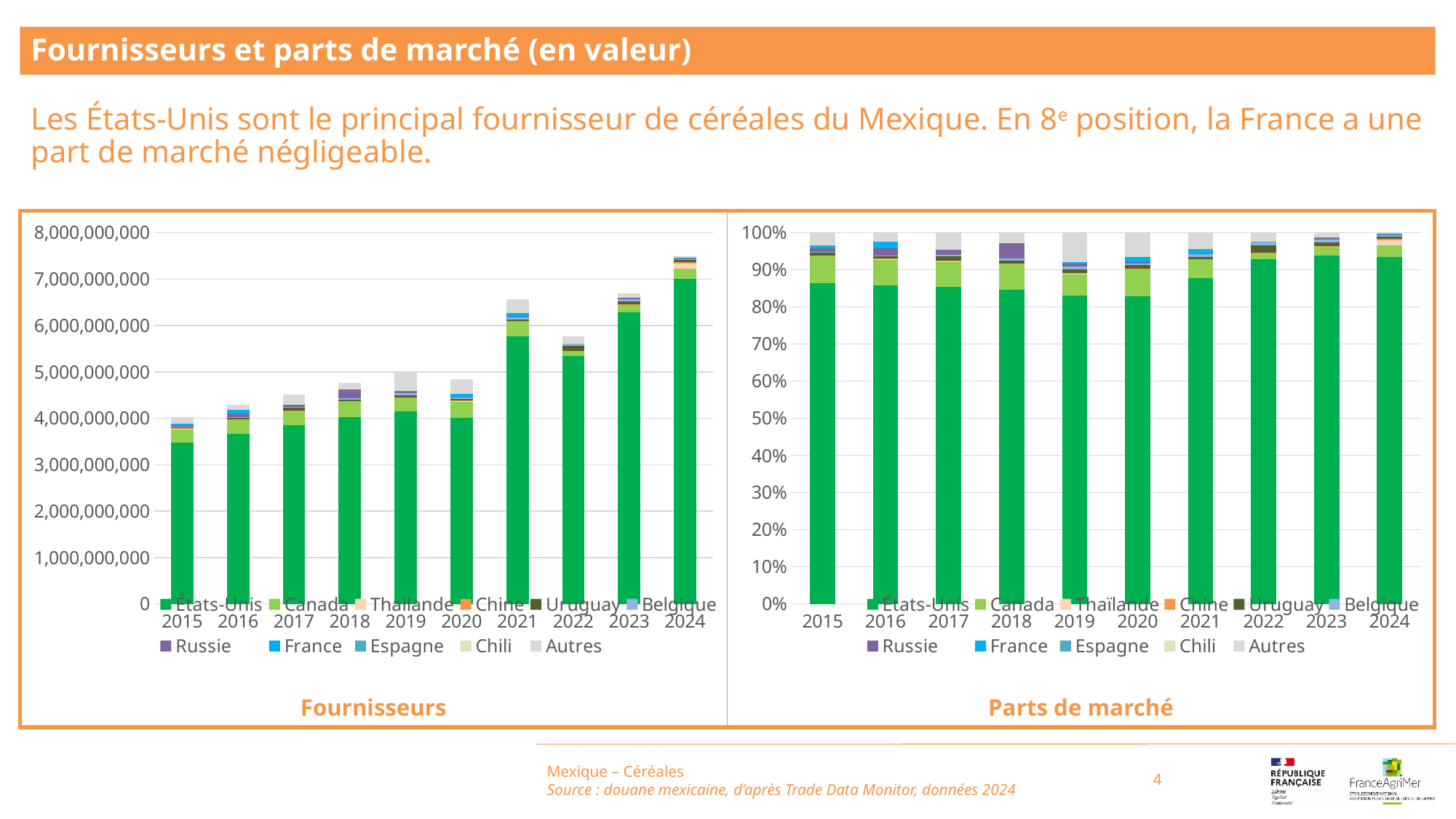
In the Fournisseurs chart, is the total bar for 2024 greater or less than 7,000,000,000? greater In the Fournisseurs chart, which year has the highest total bar? 2024 How many years are shown on the x axis of the Fournisseurs chart? 10 What kind of chart is the Fournisseurs chart on the left? stacked bar chart How many series does the legend of the Parts de marché chart list? 11 Which series is shown in dark green at the bottom of the bars in both charts? États-Unis In the Parts de marché chart, is the États-Unis share for 2020 greater or less than 90%? less In the Fournisseurs chart, is the total bar for 2022 greater or less than 6,000,000,000? less In the Fournisseurs chart, which total bar is larger, 2021 or 2022? 2021 In the Fournisseurs chart, which year has the lowest total bar? 2015